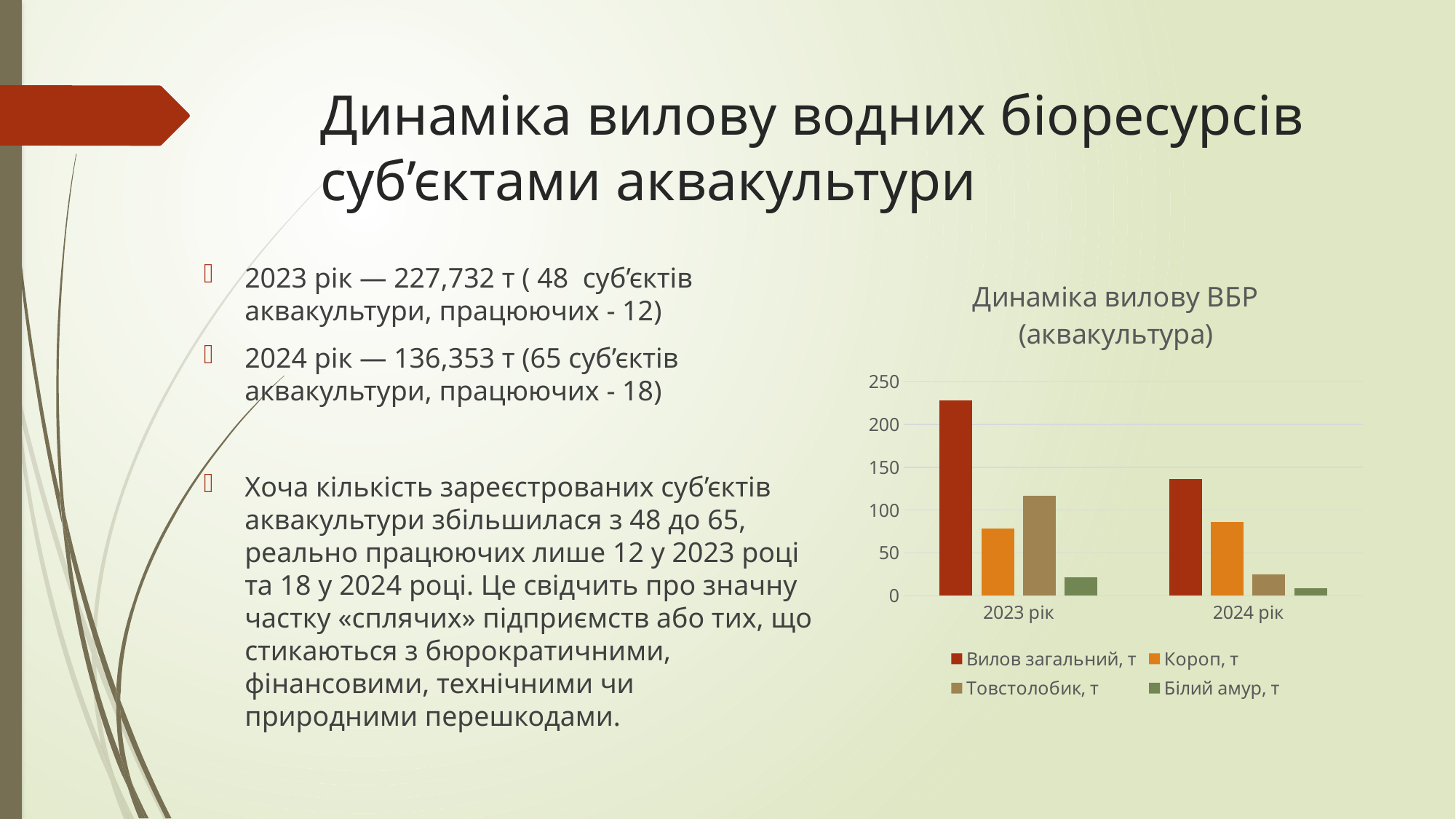
Does the value for Вилов загальний, т rise or fall from 2023 рік to 2024 рік? fall Is the bar for Товстолобик, т larger in 2023 рік or in 2024 рік? 2023 рік Is the bar for Короп, т larger in 2023 рік or in 2024 рік? 2024 рік Is the value for Вилов загальний, т in 2023 рік greater or less than 200? greater Which series has the lowest bar for 2024 рік? Білий амур, т Which series has the lowest bar for 2023 рік? Білий амур, т How many series does the chart legend list? 4 How many categories (years) are shown on the x axis of the chart? 2 What is the title of the chart? Динаміка вилову ВБР (аквакультура) What kind of chart is shown on the slide? Bar chart Is the value for Вилов загальний, т in 2024 рік greater or less than 150? less Which series has the highest bar for 2023 рік? Вилов загальний, т